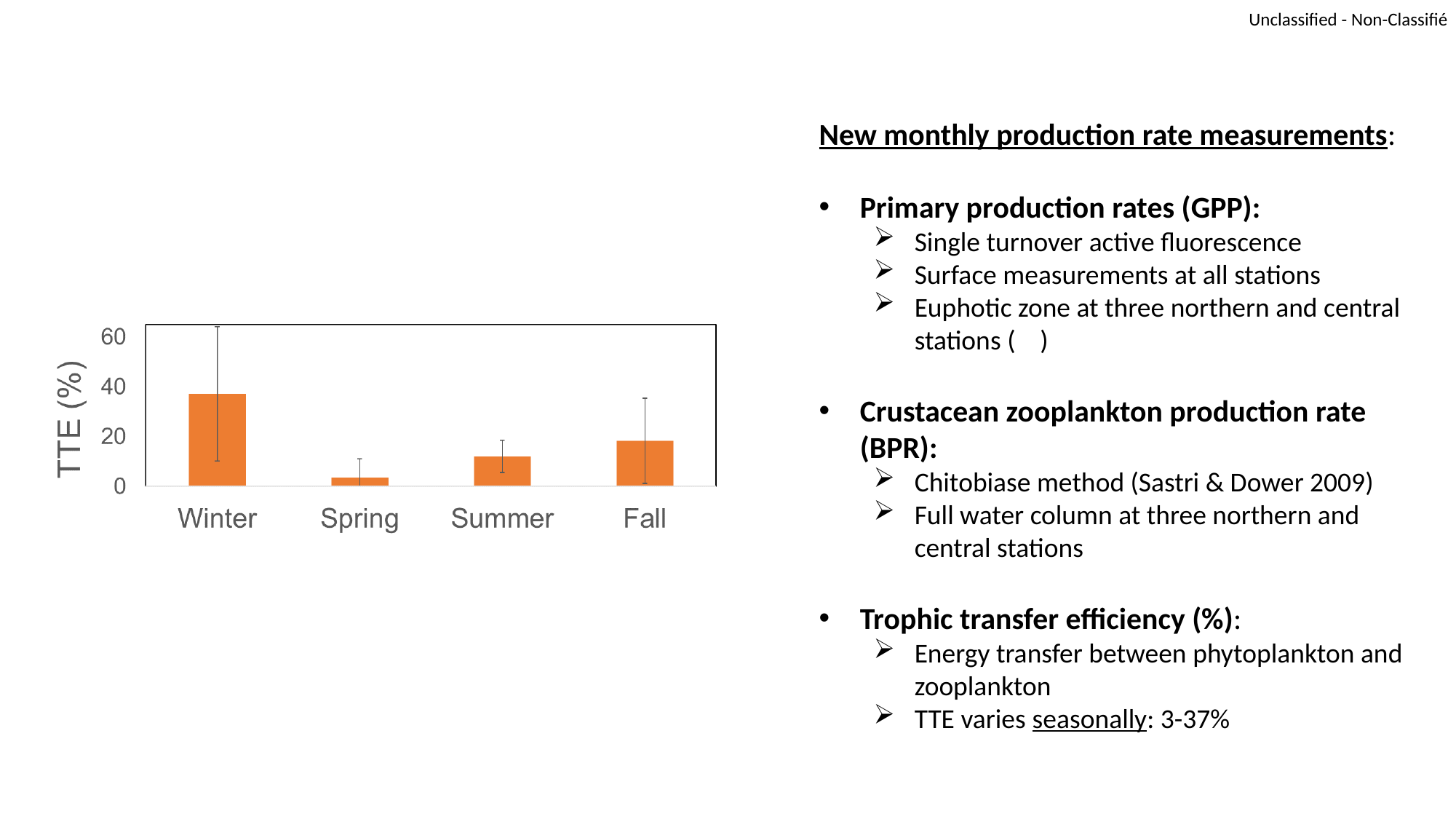
Is the TTE value for Summer greater or less than 20? less What kind of chart is shown on the slide? bar chart Which season has the lowest TTE (%) in the chart? Spring Is the TTE value for Spring greater or less than 20? less What is the label on the y axis of the chart? TTE (%) Which season has the highest TTE (%) in the chart? Winter Which has a larger TTE value, Summer or Fall? Fall Do the TTE values rise or fall from Spring through Summer to Fall? rise Is the TTE value for Winter greater or less than 20? greater Which has a larger TTE value, Winter or Fall? Winter How many seasons are plotted on the x axis of the chart? 4